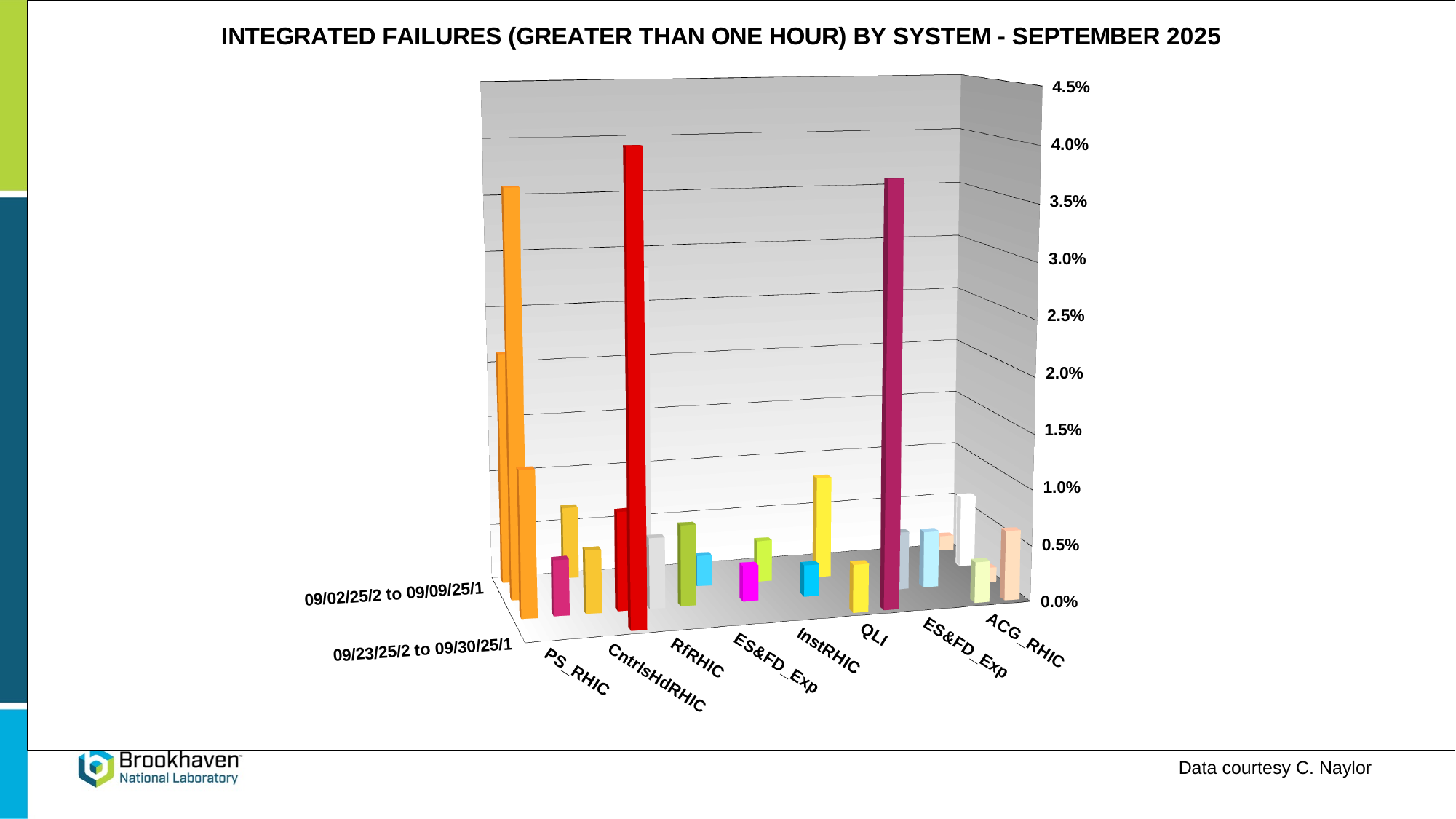
Is the tallest bar for InstRHIC greater or less than 1.5%? less Which is larger, the tallest bar for QLI or the tallest bar for ACG_RHIC? QLI Is the tallest bar for ACG_RHIC greater or less than 1.0%? less How many system categories are labelled along the x axis? 8 What is the highest value shown on the vertical axis? 4.5% Which is larger, the tallest bar for CntrlsHdRHIC or the tallest bar for InstRHIC? CntrlsHdRHIC Is the tallest bar for PS_RHIC greater or less than 2.0%? greater What kind of chart is shown on the slide? bar chart What is the title of the chart? INTEGRATED FAILURES (GREATER THAN ONE HOUR) BY SYSTEM - SEPTEMBER 2025